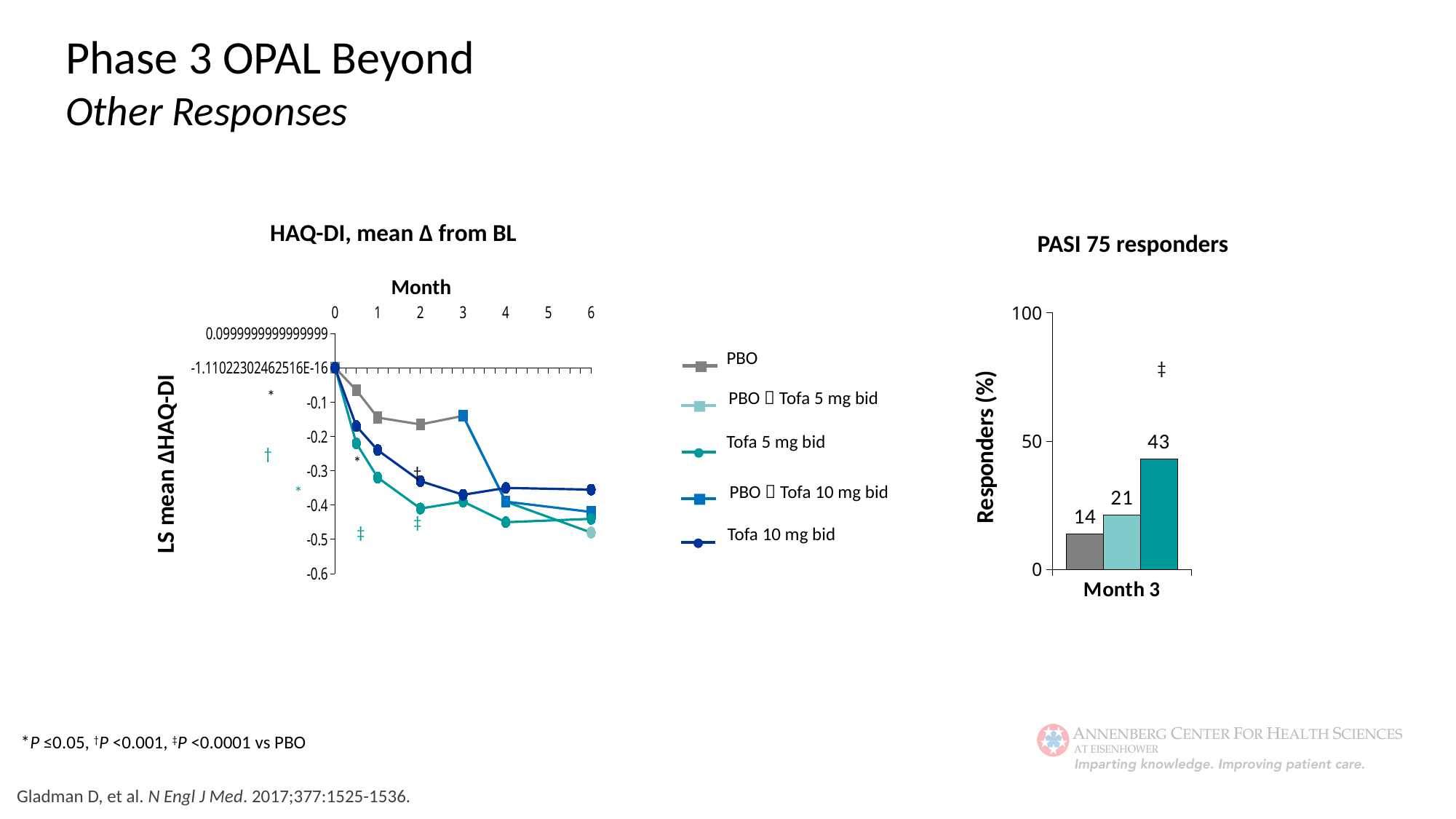
In the HAQ-DI, mean Δ from BL chart, does the Tofa 5 mg bid line rise or fall from month 0 to month 6? Fall In the PASI 75 responders chart, what is the value of the shortest bar? 14 In the HAQ-DI, mean Δ from BL chart, is the PBO value at month 3 greater or less than -0.2? greater In the PASI 75 responders chart, what time point is labelled on the x axis? Month 3 In the PASI 75 responders chart, what is the difference between the tallest bar and the shortest bar? 29 In the PASI 75 responders chart, what is the value of the tallest bar? 43 What kind of chart is the PASI 75 responders chart? Bar chart How many series does the legend of the HAQ-DI, mean Δ from BL chart list? 5 In the PASI 75 responders chart, how many bars are shown? 3 In the PASI 75 responders chart, what is the value of the middle bar? 21 What kind of chart is the HAQ-DI, mean Δ from BL chart? Line chart In the HAQ-DI, mean Δ from BL chart, is the Tofa 5 mg bid value at month 3 greater or less than -0.3? less